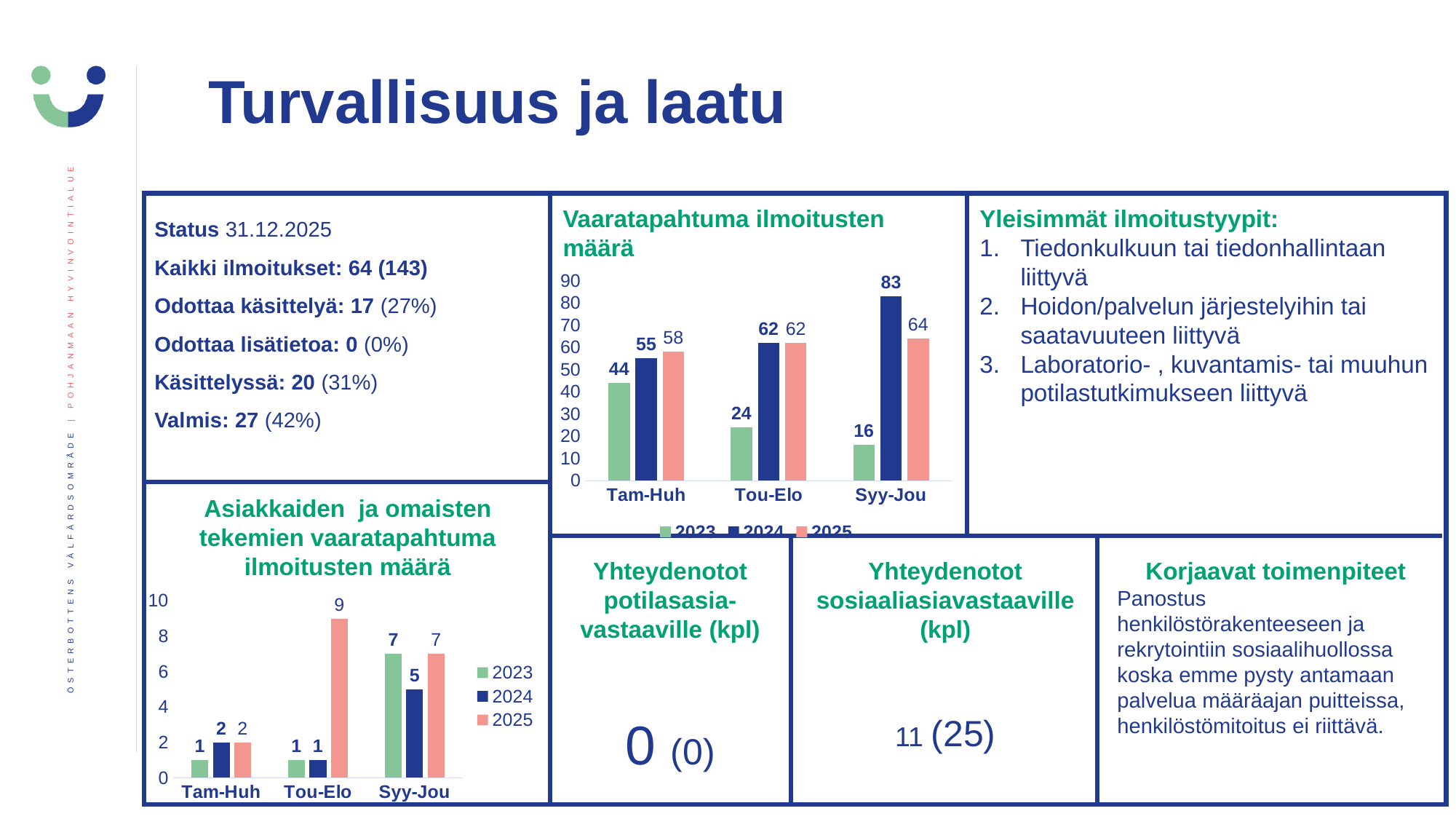
In the 'Vaaratapahtuma ilmoitusten määrä' chart, how many series does the legend list? 3 In the 'Vaaratapahtuma ilmoitusten määrä' chart, what is the difference between the 2024 and 2025 values in Syy-Jou? 19 In the 'Vaaratapahtuma ilmoitusten määrä' chart, what is the value for 2024 in Syy-Jou? 83 In the 'Asiakkaiden ja omaisten tekemien vaaratapahtuma ilmoitusten määrä' chart, what is the value for 2025 in Tou-Elo? 9 In the 'Asiakkaiden ja omaisten tekemien vaaratapahtuma ilmoitusten määrä' chart, what is the value for 2024 in Syy-Jou? 5 In the 'Vaaratapahtuma ilmoitusten määrä' chart, do the 2023 values rise or fall from Tam-Huh to Syy-Jou? fall In the 'Asiakkaiden ja omaisten tekemien vaaratapahtuma ilmoitusten määrä' chart, which is larger in Syy-Jou: the 2023 value or the 2024 value? 2023 In the 'Vaaratapahtuma ilmoitusten määrä' chart, which period has the lowest 2023 value? Syy-Jou In the 'Asiakkaiden ja omaisten tekemien vaaratapahtuma ilmoitusten määrä' chart, how many periods are shown on the x axis? 3 What type of chart is the 'Asiakkaiden ja omaisten tekemien vaaratapahtuma ilmoitusten määrä' chart? bar chart In the 'Vaaratapahtuma ilmoitusten määrä' chart, which period has the highest 2024 value? Syy-Jou In the 'Vaaratapahtuma ilmoitusten määrä' chart, what is the value for 2023 in Tou-Elo? 24